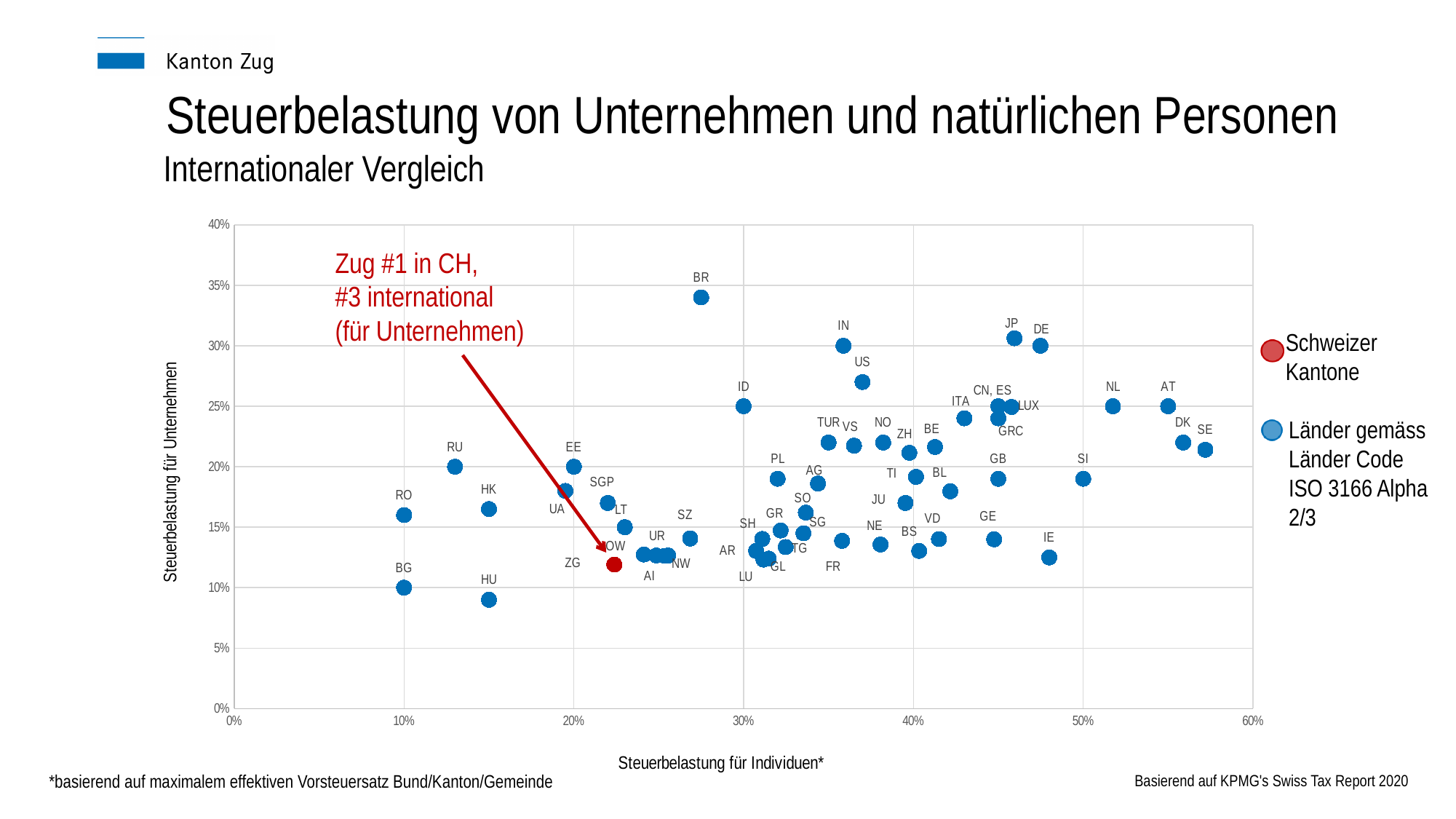
Which point has the lowest Steuerbelastung für Unternehmen? HU Is the Steuerbelastung für Unternehmen for IE greater or less than 15%? less What kind of chart is shown on the slide? scatter chart Which has the higher Steuerbelastung für Unternehmen, DE or BR? BR Is the Steuerbelastung für Unternehmen for BR greater or less than 30%? greater What does the red point in the chart represent according to the legend? Schweizer Kantone Is the Steuerbelastung für Unternehmen for ID greater or less than 20%? greater Which country has the highest Steuerbelastung für Unternehmen? BR How many series does the legend list? 2 Which has the higher Steuerbelastung für Unternehmen, HU or RU? RU